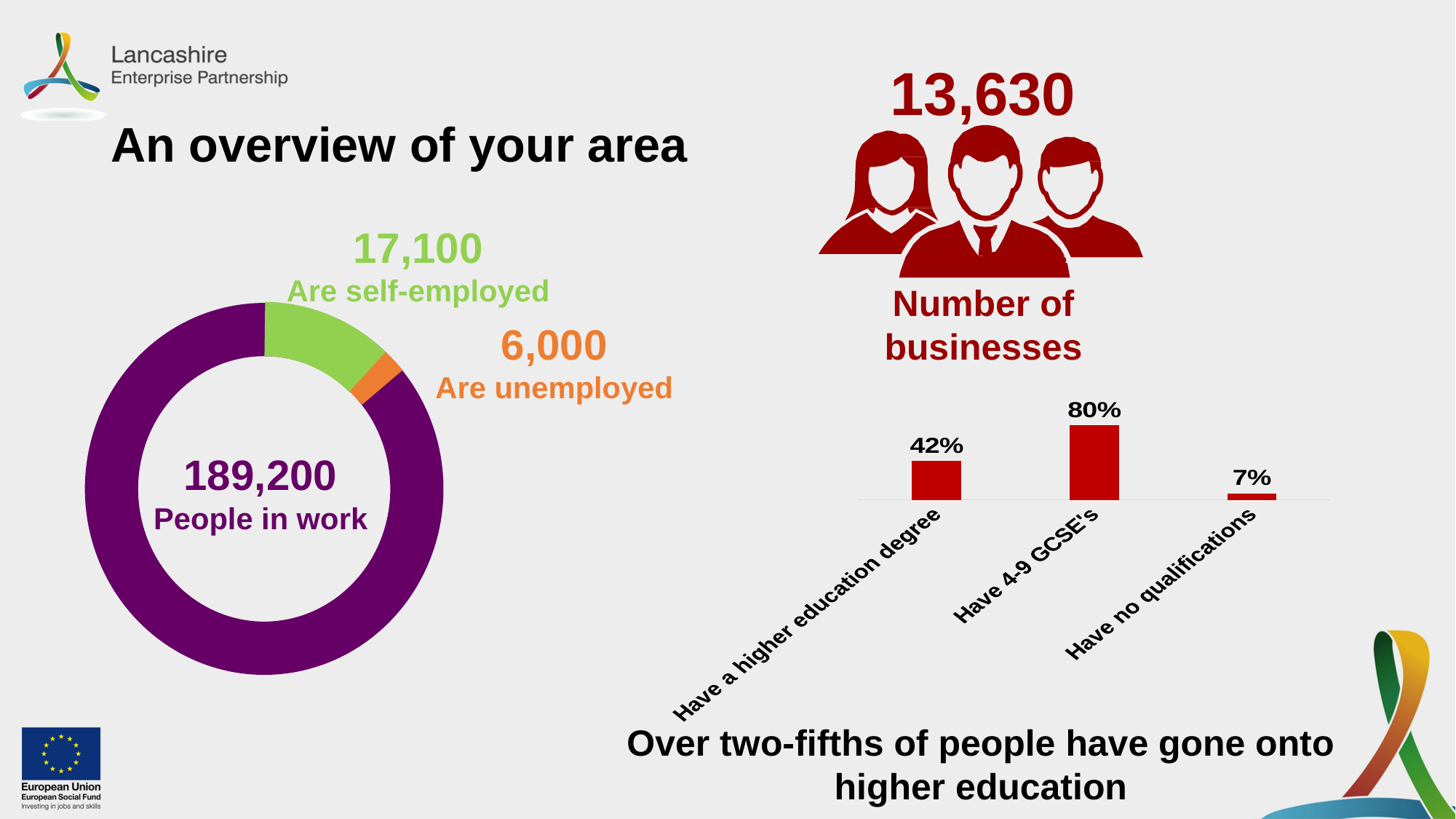
In the bar chart on the right, what percentage of people have a higher education degree? 42% In the bar chart on the right, what is the difference in percentage points between those with 4-9 GCSE's and those with a higher education degree? 38 In the doughnut chart on the left, how many people are in work? 189,200 In the doughnut chart on the left, what colour is the segment for people who are unemployed? Orange In the bar chart on the right, which category has the lowest value? Have no qualifications In the bar chart on the right, how many categories are shown? 3 In the doughnut chart on the left, how many people are self-employed? 17,100 In the bar chart on the right, what percentage of people have 4-9 GCSE's? 80% In the bar chart on the right, what percentage of people have no qualifications? 7% What kind of chart is the chart on the right of the slide? Bar chart In the bar chart on the right, which category has the highest value? Have 4-9 GCSE's In the doughnut chart on the left, which is larger: the number of self-employed people or the number of unemployed people? Self-employed